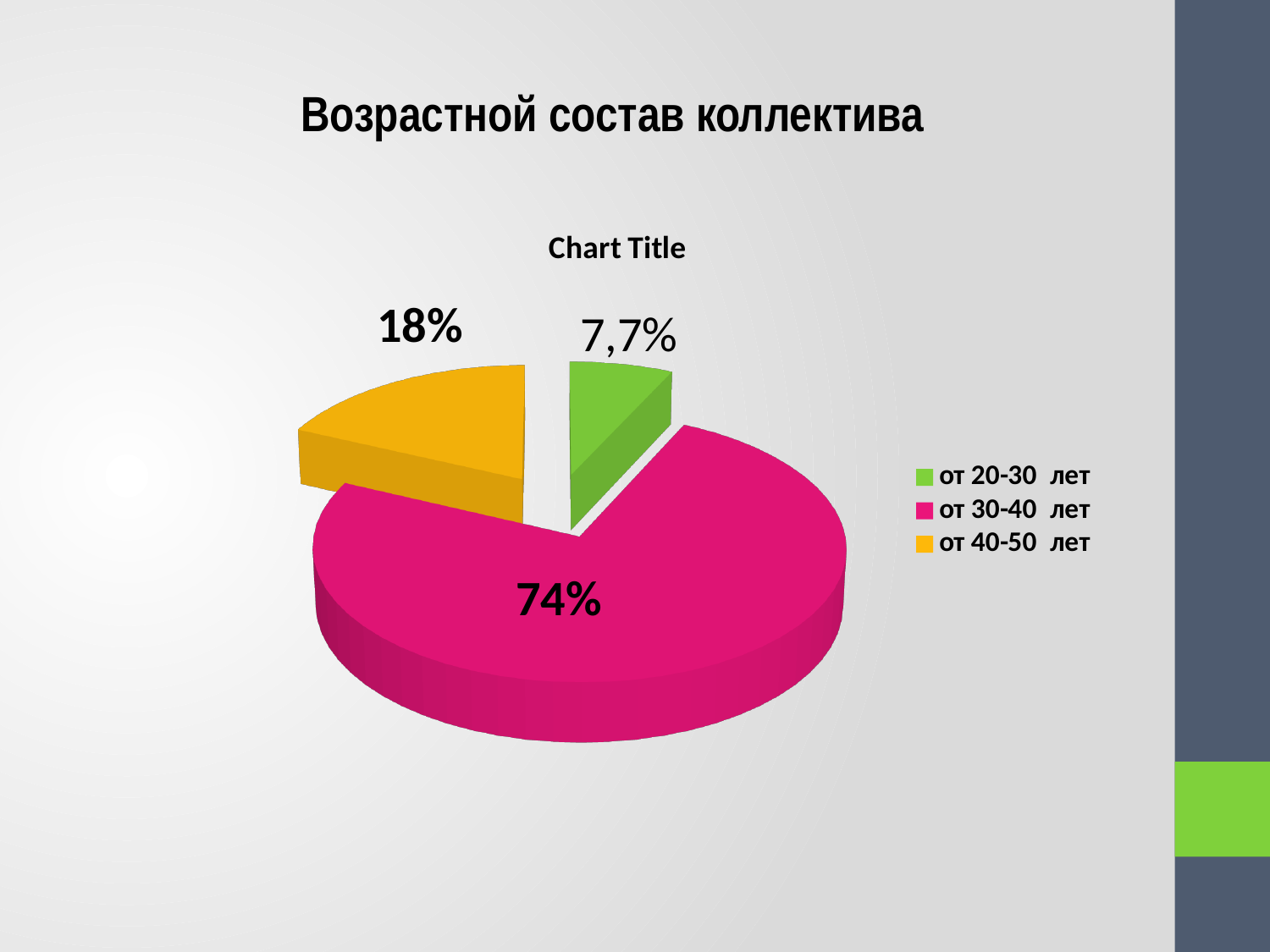
What is the title printed above the pie chart? Chart Title What colour is the 'от 30-40 лет' slice? pink How many entries does the legend list? 3 What kind of chart is shown on the slide? pie chart What is the difference between the 'от 30-40 лет' share and the 'от 40-50 лет' share? 56% Which age group has the largest slice of the pie? от 30-40 лет Which slice is larger: 'от 40-50 лет' or 'от 20-30 лет'? от 40-50 лет What share of the pie does the 'от 20-30 лет' slice have? 7,7% Which age group has the smallest slice of the pie? от 20-30 лет How many slices does the pie chart have? 3 What share of the pie does the 'от 30-40 лет' slice have? 74% What share of the pie does the 'от 40-50 лет' slice have? 18%